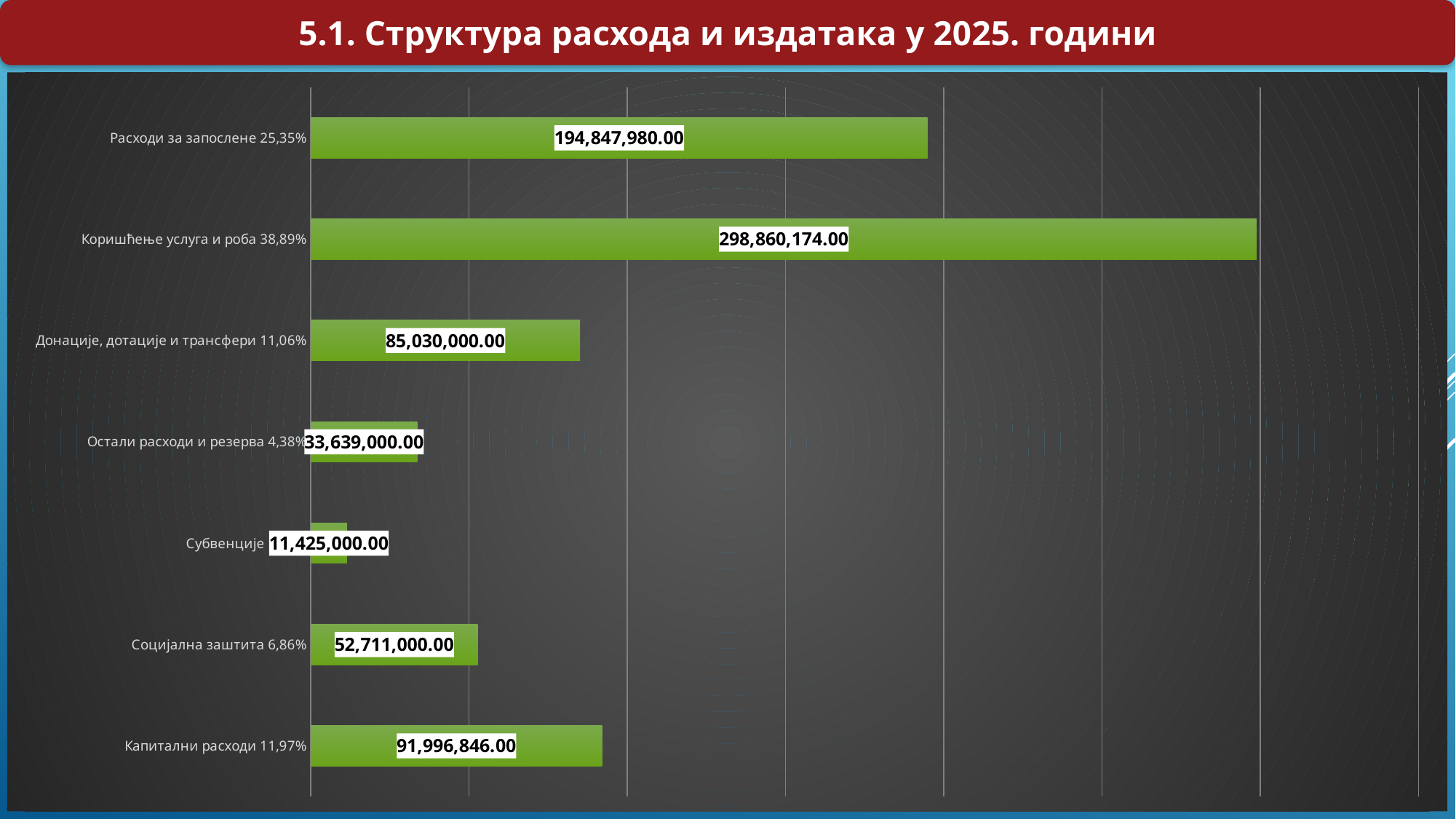
How many categories are shown in the chart? 7 Which is larger, the value for Донације, дотације и трансфери or the value for Капитални расходи? Капитални расходи What is the value for Капитални расходи? 91,996,846.00 What type of chart is shown on the slide? bar chart What is the value for Коришћење услуга и роба? 298,860,174.00 What is the difference between the values for Социјална заштита and Остали расходи и резерва? 19,072,000.00 What is the value for Субвенције? 11,425,000.00 What is the difference between the values for Коришћење услуга и роба and Расходи за запослене? 104,012,194.00 Which category has the lowest value? Субвенције What is the value for Расходи за запослене? 194,847,980.00 Which category has the highest value? Коришћење услуга и роба What is the value for Социјална заштита? 52,711,000.00